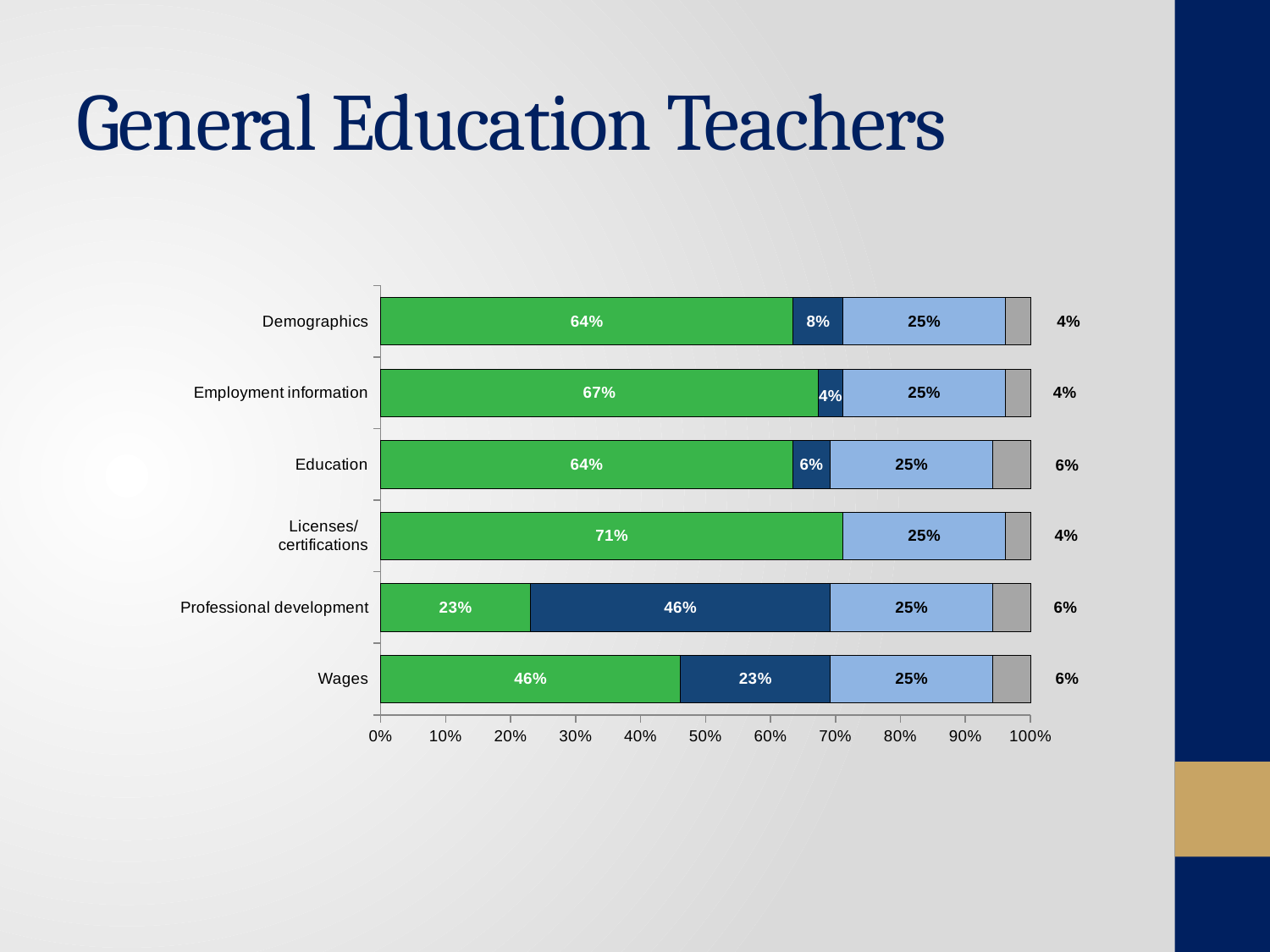
What is the difference between the green segment for Employment information and the green segment for Demographics? 3% Which category has the smallest green segment? Professional development What is the value of the grey segment for Education? 6% What type of chart is shown on the slide? Stacked bar chart Which category has the largest green segment? Licenses/certifications What is the value of the green segment for Wages? 46% What is the value of the dark blue segment for Professional development? 46% How many categories are shown on the chart? 6 What is the value of the green segment for Licenses/certifications? 71% What is the value of the dark blue segment for Demographics? 8% What is the value of the light blue segment for Employment information? 25% Which is larger: the green segment for Wages or the green segment for Professional development? Wages